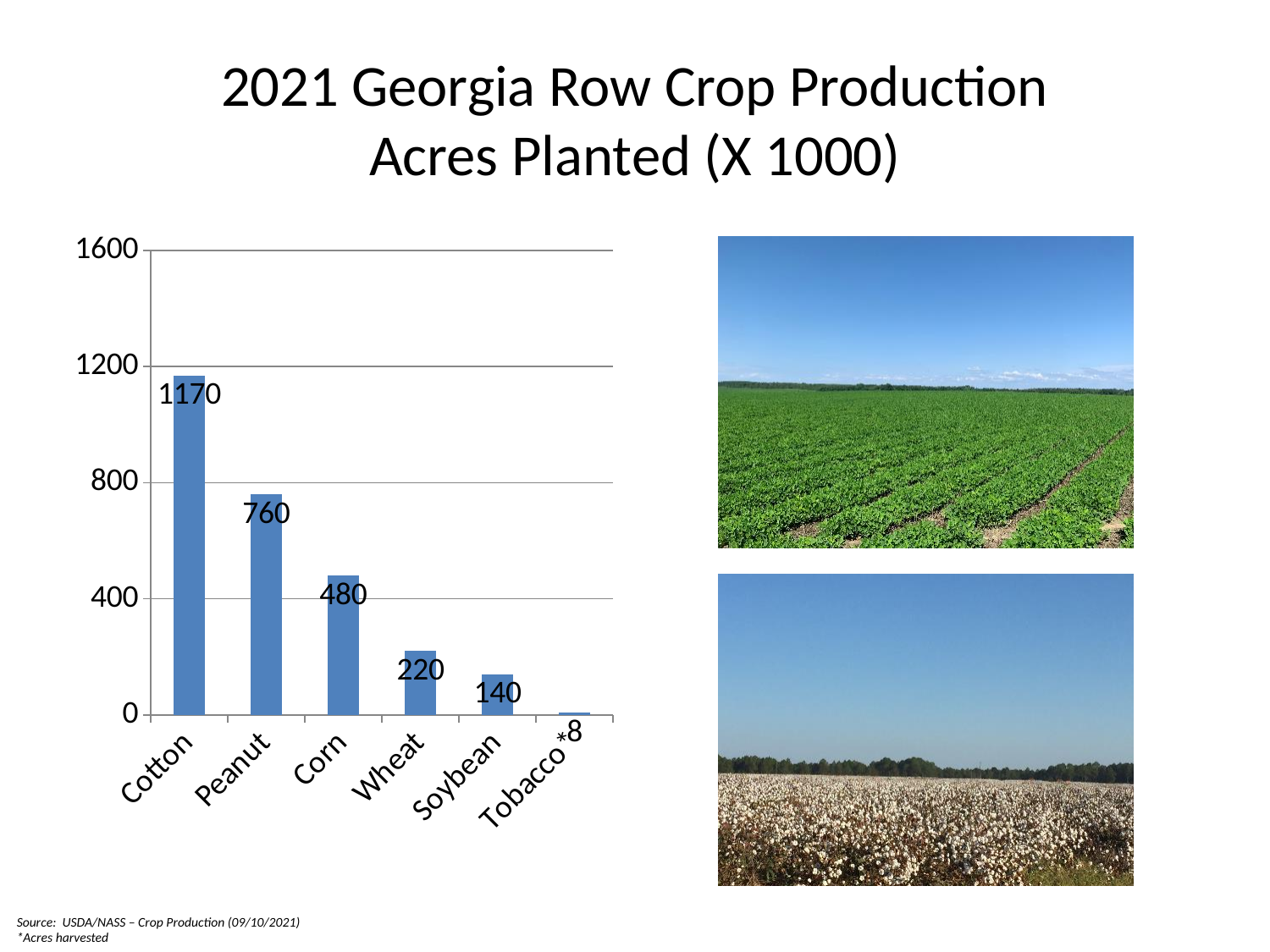
What is the difference between the values for Corn and Wheat? 260 How many crops are shown on the chart? 6 Is the value for Peanut greater or less than 800? less What is the value for Peanut? 760 What is the value for Corn? 480 Which crop has the highest acres planted? Cotton What is the value for Soybean? 140 What kind of chart is shown on the slide? bar chart What is the value for Cotton? 1170 Which is larger, the value for Wheat or the value for Soybean? Wheat Which crop has the lowest acres planted? Tobacco* What is the difference between the values for Cotton and Peanut? 410